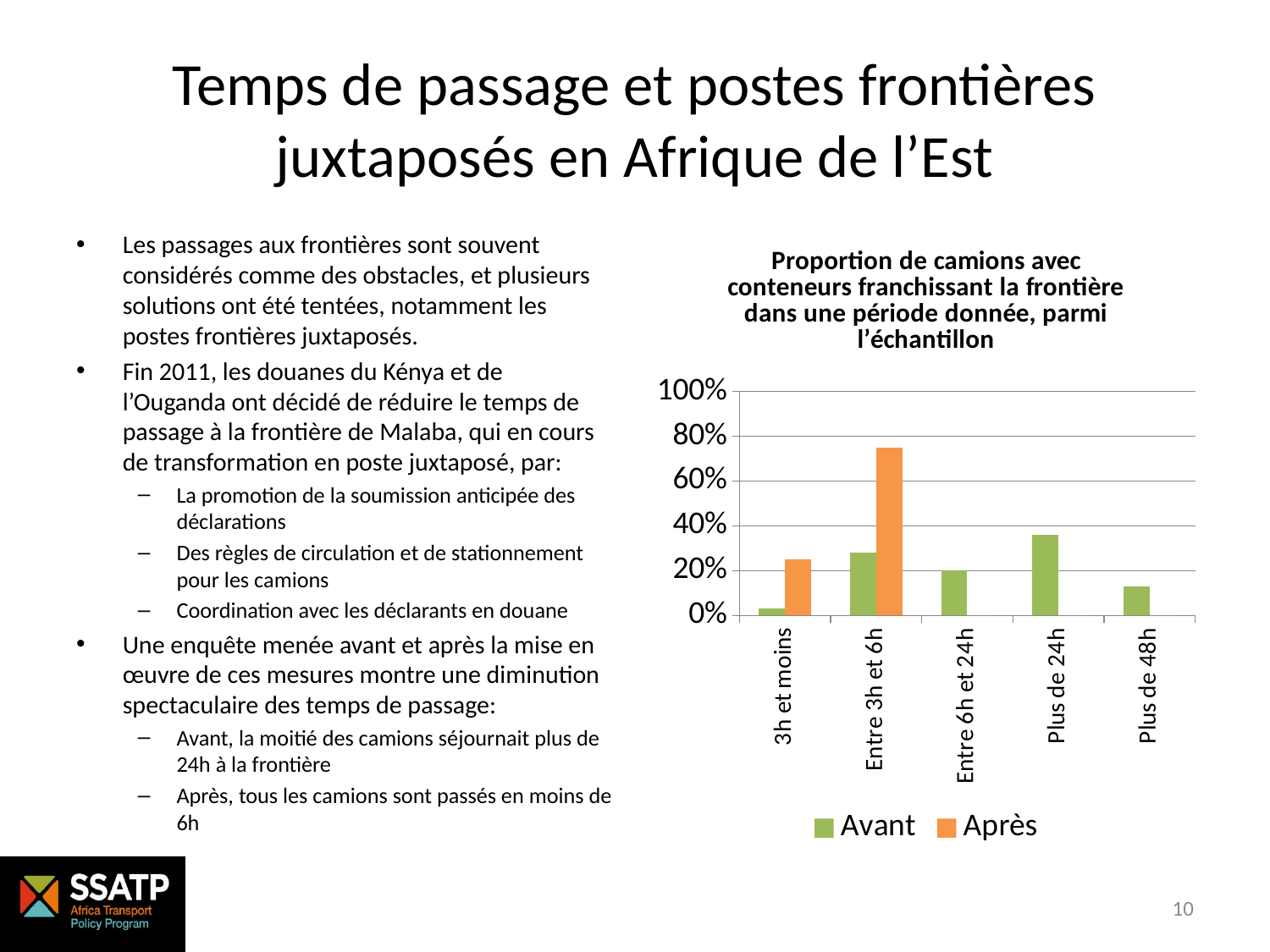
What kind of chart is shown on the slide? bar chart Which category has the lowest value for the Avant series? 3h et moins How many categories are shown on the x axis of the chart? 5 Is the Après value for 3h et moins greater or less than 20%? greater Is the Après value for Entre 3h et 6h greater or less than 60%? greater Which colour represents the Après series in the chart? orange For the category Entre 3h et 6h, which series has the larger value, Avant or Après? Après Is the Avant value for Plus de 48h greater or less than 20%? less Which category has the highest value for the Après series? Entre 3h et 6h Which category has the highest value for the Avant series? Plus de 24h How many series does the chart legend list? 2 For the category 3h et moins, which series has the larger value, Avant or Après? Après